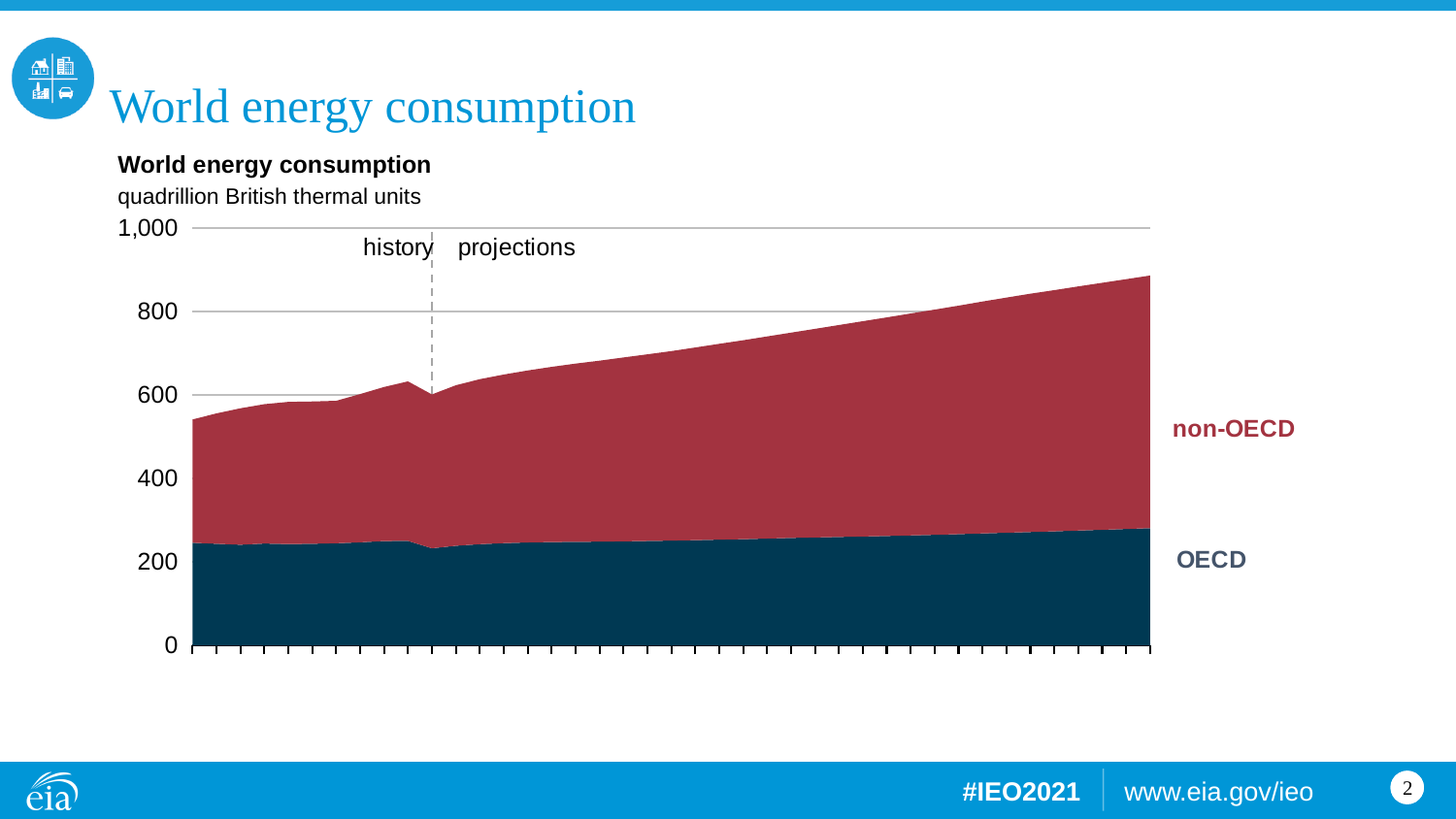
What unit is the chart measured in? quadrillion British thermal units Is the OECD energy consumption at the end of the projection period greater or less than 400? less What are the two series shown in the chart? non-OECD and OECD Is the total world energy consumption at the start of the history period greater or less than 600? less Is the total world energy consumption at the end of the projection period greater or less than 1,000? less Does total world energy consumption rise or fall over the projection period? Rise How many series does the chart show? 2 Which series is shown in dark blue at the bottom of the chart? OECD What kind of chart is shown on the slide? Stacked area chart Which series accounts for the larger share of world energy consumption at the end of the projection period, OECD or non-OECD? non-OECD